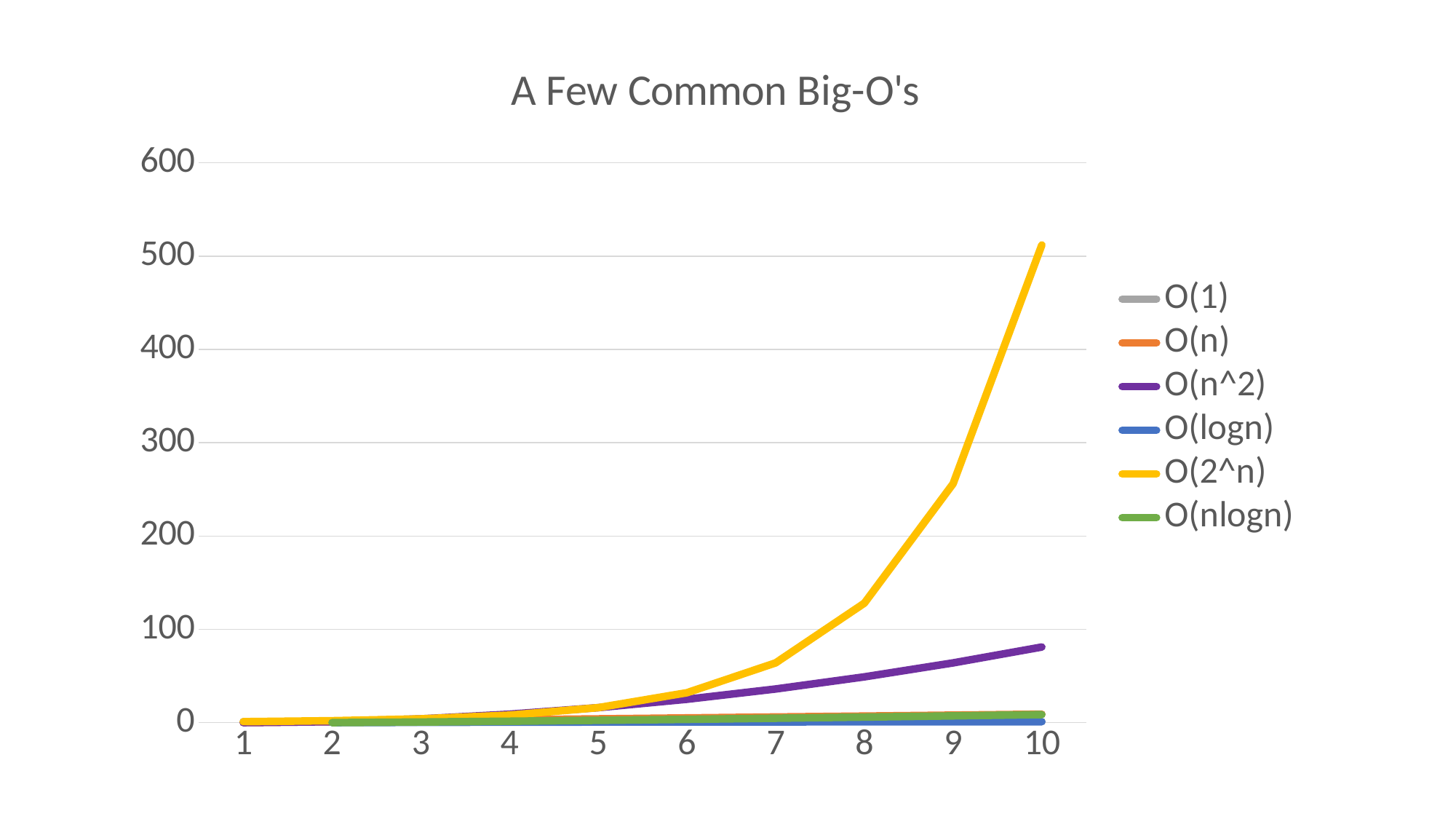
Which series has the highest value at x = 10? O(2^n) How many points are there along the x axis? 10 At x = 10, which is larger, O(2^n) or O(n^2)? O(2^n) Does the O(2^n) series rise or fall as x increases from 1 to 10? rise What is the title of the chart? A Few Common Big-O's Is the value of O(2^n) at x = 9 greater or less than 300? less Which colour is used for the O(2^n) series? yellow What kind of chart is shown on the slide? line chart Is the value of O(n^2) at x = 10 greater or less than 100? less Is the value of O(2^n) at x = 8 greater or less than 100? greater How many series does the legend list? 6